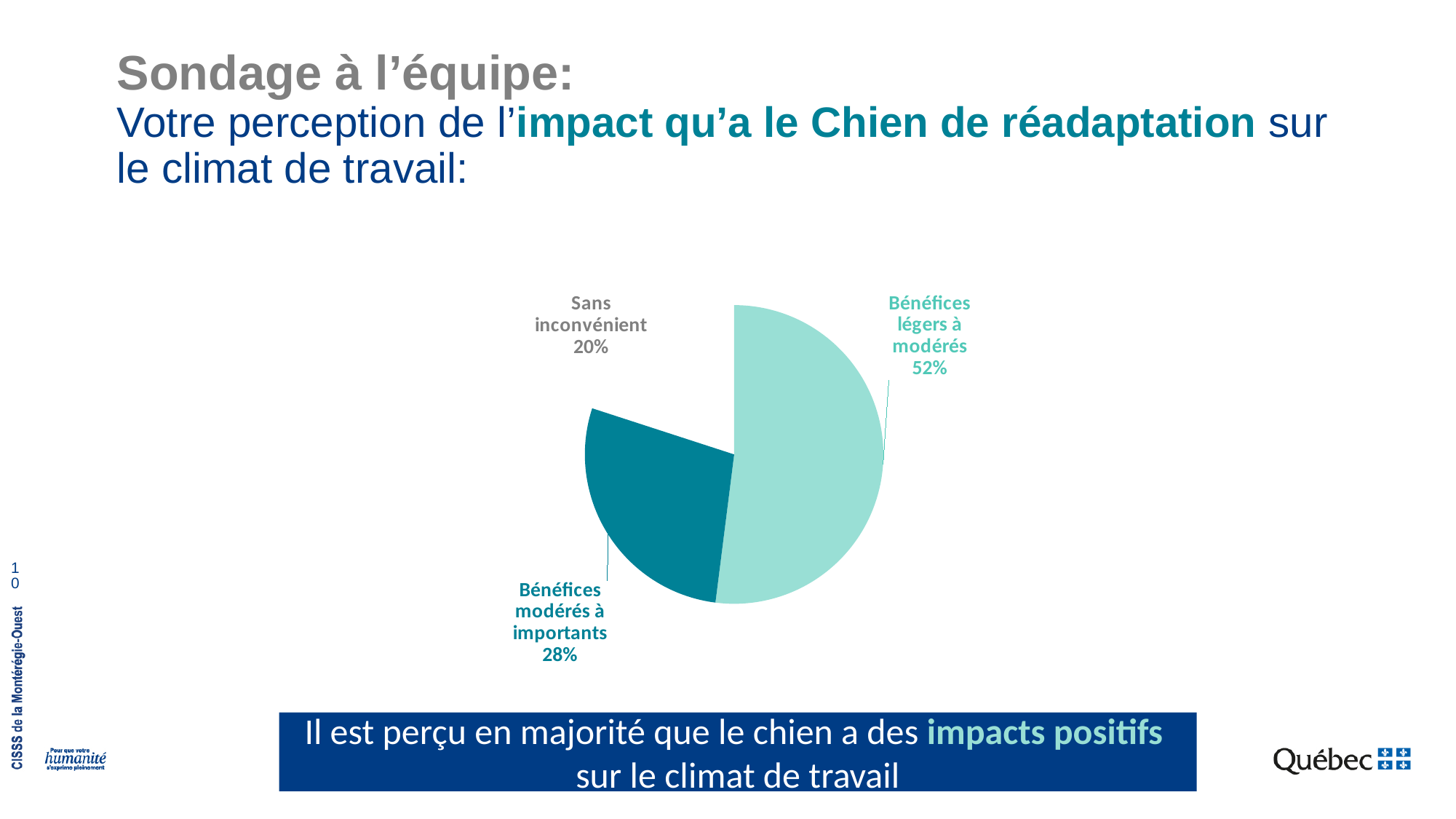
What share of the pie does "Bénéfices légers à modérés" represent? 52% What is the difference in percentage points between "Bénéfices légers à modérés" and "Bénéfices modérés à importants"? 24 What kind of chart is shown on the slide? Pie chart What is the difference in percentage points between "Bénéfices modérés à importants" and "Sans inconvénient"? 8 Which category has the largest slice of the pie? Bénéfices légers à modérés What share of the pie does "Sans inconvénient" represent? 20% What is the combined share of the two "Bénéfices" categories? 80% Which is larger: the share for "Bénéfices modérés à importants" or the share for "Sans inconvénient"? Bénéfices modérés à importants What share of the pie does "Bénéfices modérés à importants" represent? 28% Which category has the smallest slice of the pie? Sans inconvénient Which slice of the pie is shown in the darkest teal colour? Bénéfices modérés à importants How many categories are shown in the pie chart? 3